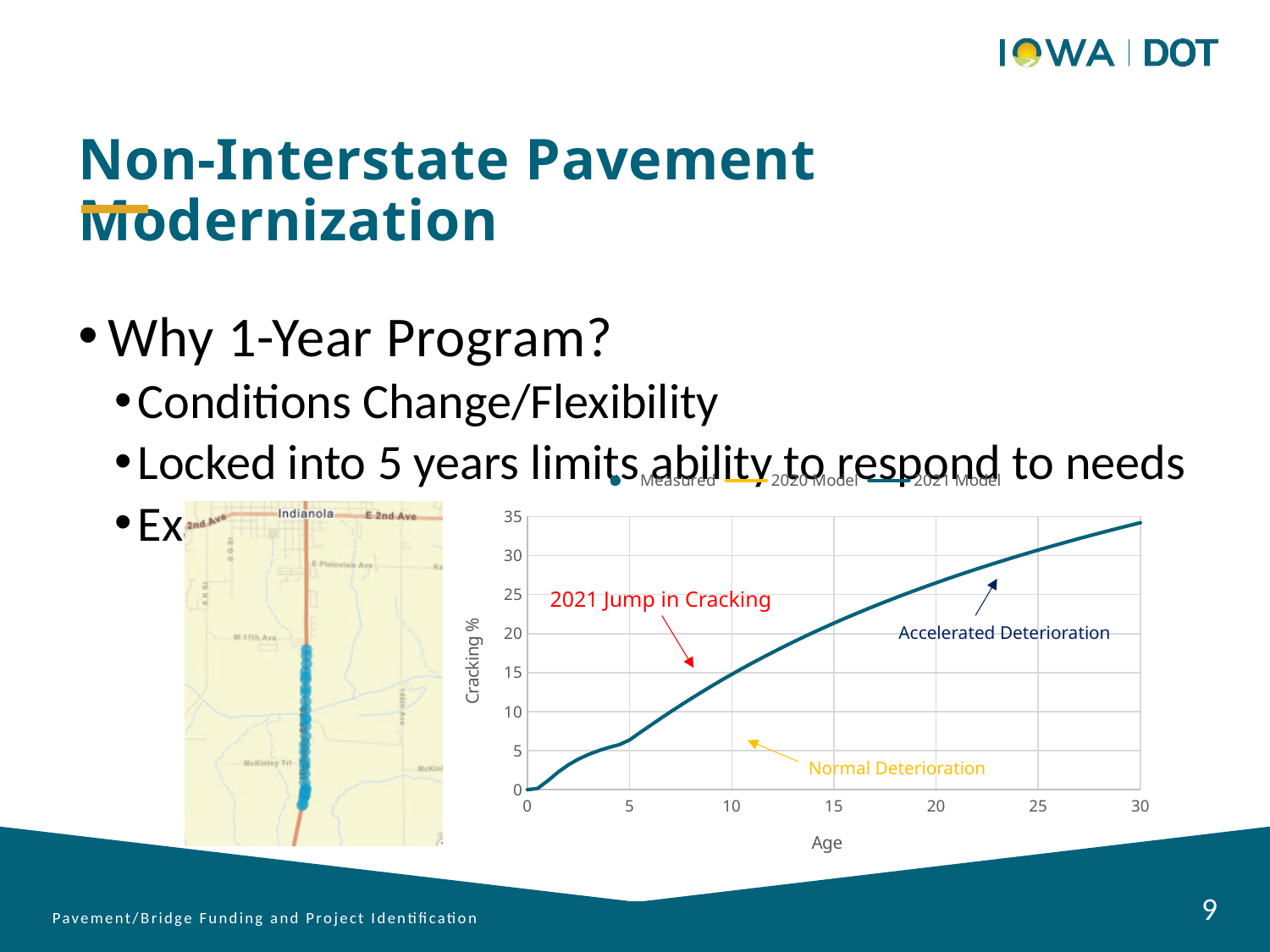
What is the label of the y axis of the chart? Cracking % How many series does the chart legend list? 3 Is the cracking % at age 20 greater or less than 20? greater What kind of chart is shown on the slide? line chart Is the cracking % at age 10 greater or less than 20? less Is the cracking % at age 25 greater or less than 25? greater What is the label of the x axis of the chart? Age Does the cracking percentage rise or fall as age increases along the x axis? rise What is the maximum value shown on the y axis of the chart? 35